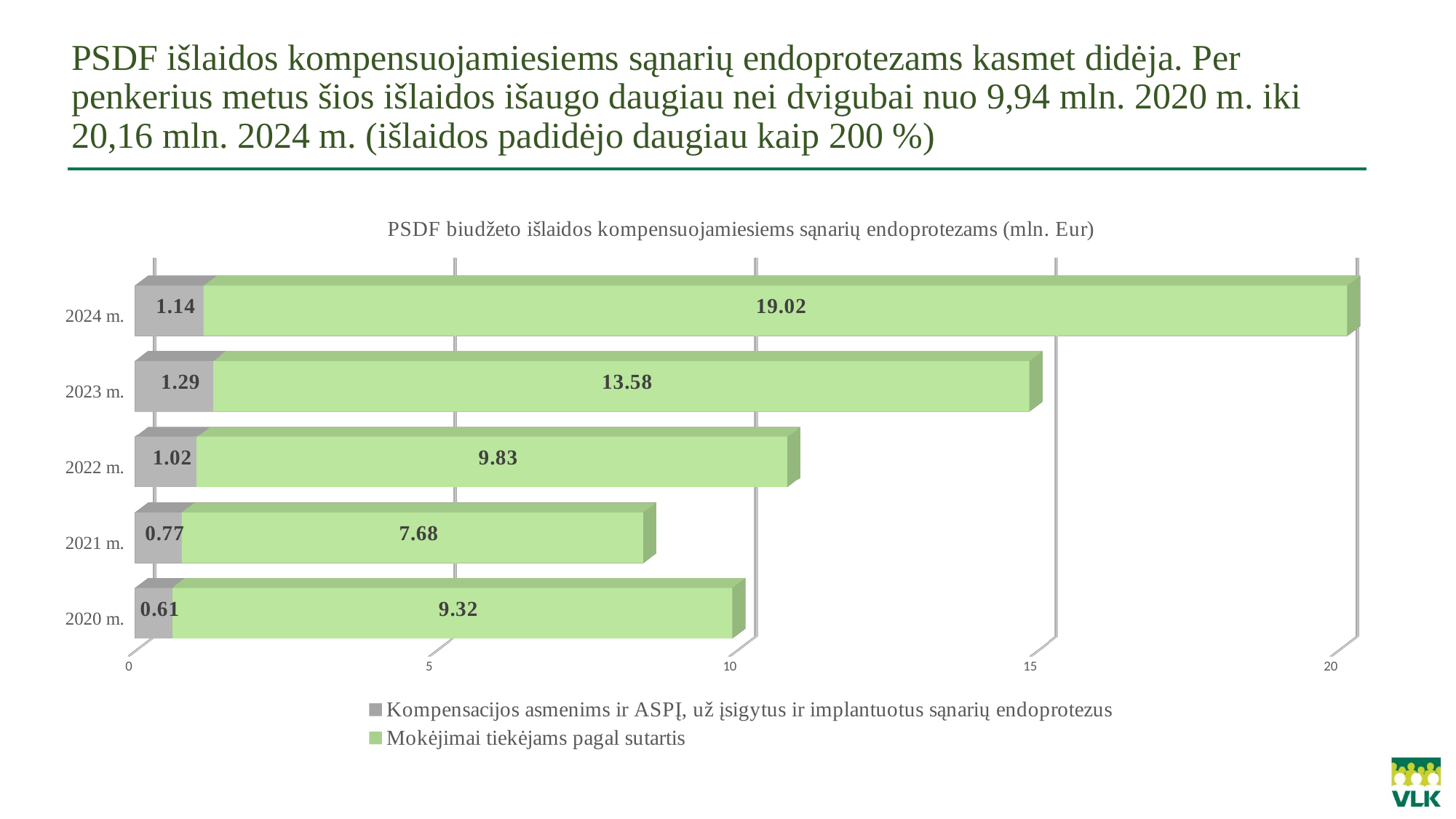
What is the difference between the Mokėjimai tiekėjams pagal sutartis values for 2024 m. and 2023 m.? 5.44 Which year has the lowest value for Mokėjimai tiekėjams pagal sutartis? 2021 m. What is the value of Kompensacijos asmenims ir ASPĮ for 2020 m.? 0.61 What is the value of Mokėjimai tiekėjams pagal sutartis for 2024 m.? 19.02 From 2021 m. to 2024 m., do the Mokėjimai tiekėjams pagal sutartis values rise or fall? Rise What is the value of Mokėjimai tiekėjams pagal sutartis for 2021 m.? 7.68 How many years are shown on the chart? 5 Which year has the highest value for Kompensacijos asmenims ir ASPĮ? 2023 m. What type of chart is shown on the slide? Stacked bar chart Which is larger: the Mokėjimai tiekėjams pagal sutartis value for 2020 m. or for 2022 m.? 2022 m. What is the total of the stacked bar for 2024 m.? 20.16 How many series does the legend list? 2